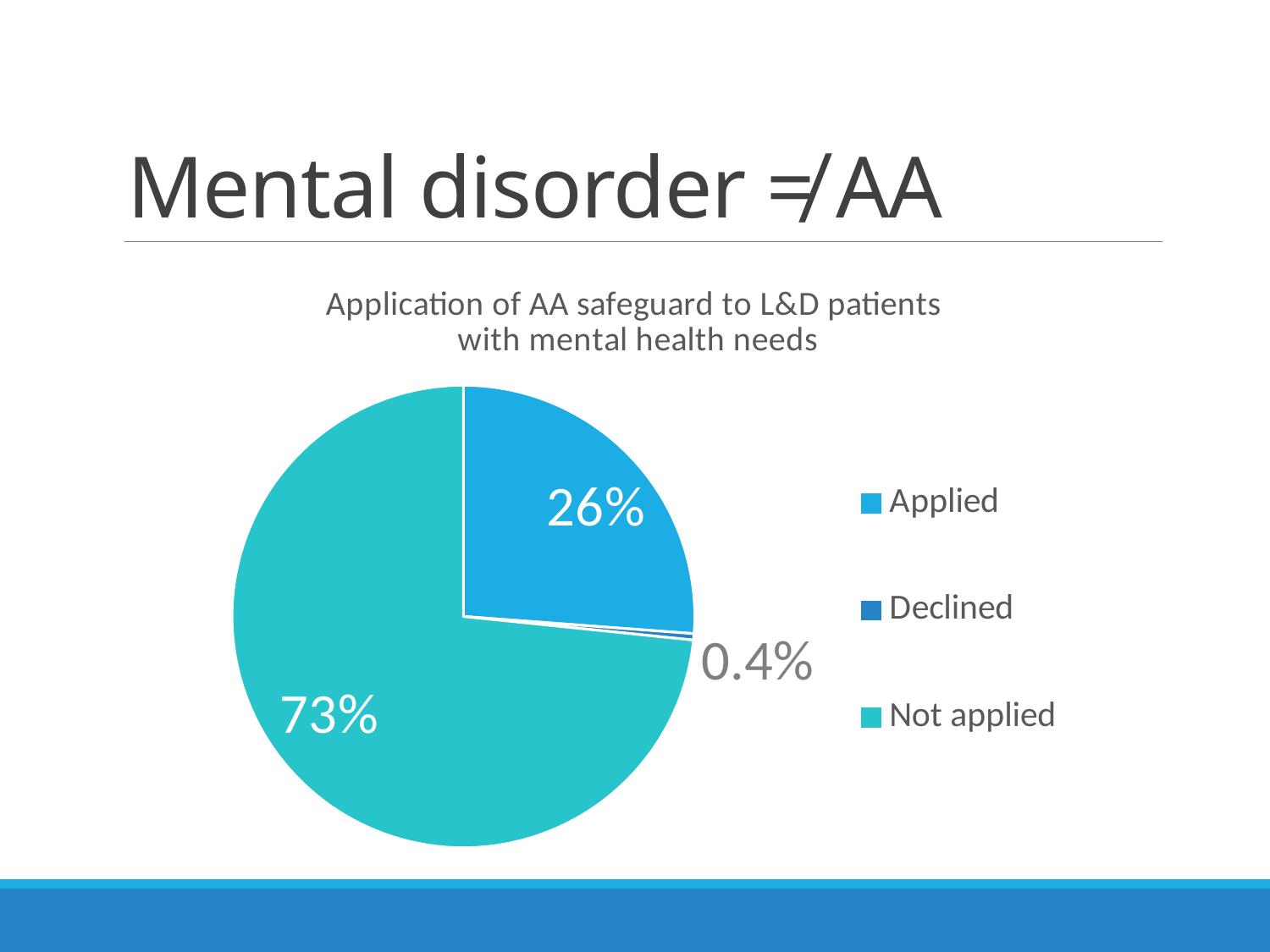
What kind of chart is shown on the slide? pie chart What share of the pie is labelled 'Declined'? 0.4% Which legend entry is listed second? Declined What is the difference in percentage points between the 'Not applied' and 'Applied' shares? 47 What is the title of the chart? Application of AA safeguard to L&D patients with mental health needs What share of the pie is labelled 'Applied'? 26% Which category has the smallest slice of the pie? Declined Which category has the largest slice of the pie? Not applied How many categories does the legend list? 3 Which is larger, the share for 'Applied' or the share for 'Not applied'? Not applied What share of the pie is labelled 'Not applied'? 73%